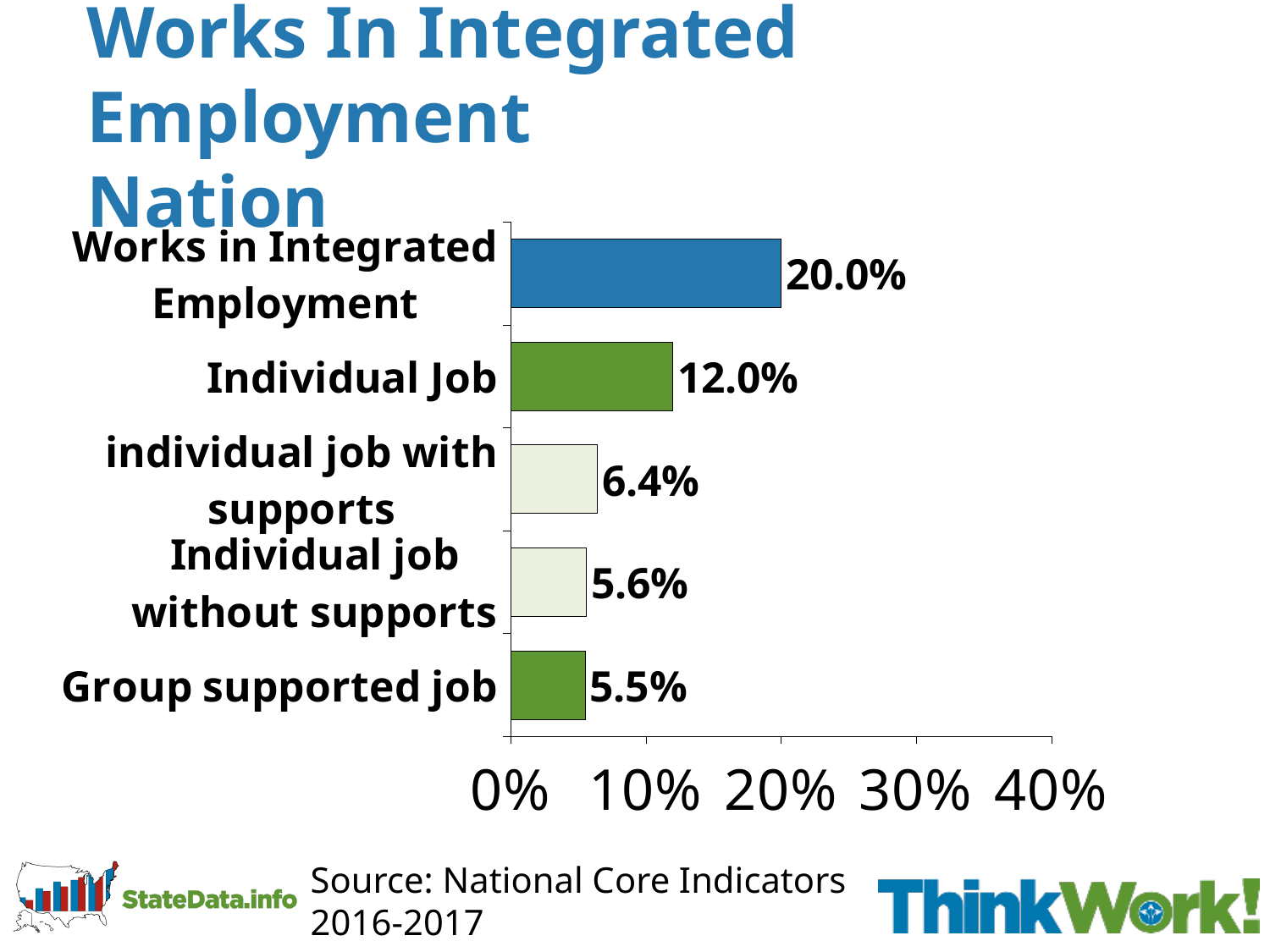
What kind of chart is shown on the slide? Bar chart What is the value for Individual Job? 12.0% Which category has the lowest value? Group supported job What is the value for Group supported job? 5.5% What is the difference between Works in Integrated Employment and Individual Job? 8.0% What is the value for individual job with supports? 6.4% What is the source cited for the chart data? National Core Indicators 2016-2017 What is the difference between individual job with supports and Individual job without supports? 0.8% Which category has the highest value? Works in Integrated Employment Which is larger, Individual Job or individual job with supports? Individual Job What is the value for Works in Integrated Employment? 20.0% How many categories are shown in the chart? 5